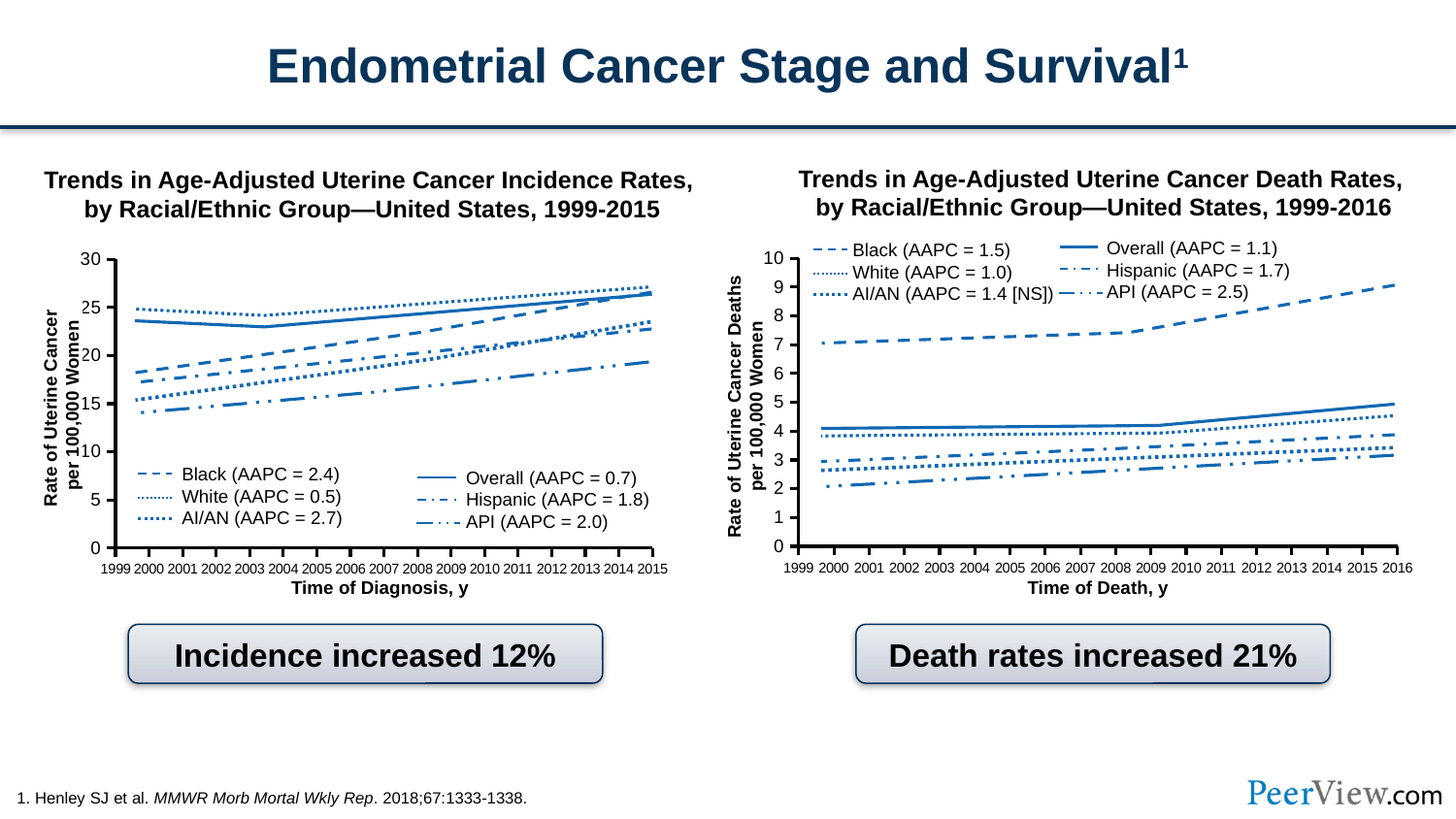
In the incidence rates chart (left), is the value for White in 1999 greater or less than 20? greater In the death rates chart (right), what AAPC value is listed for API in the legend? 2.5 In the death rates chart (right), how many series does the legend list? 6 What type of chart is the left chart showing uterine cancer incidence rates? Line chart In the incidence rates chart (left), how many series does the legend list? 6 In the death rates chart (right), is the value for API in 1999 greater or less than 3? less In the death rates chart (right), does the Black death rate rise or fall from 1999 to 2016? Rise In the incidence rates chart (left), what AAPC value is listed for Black in the legend? 2.4 In the death rates chart (right), is the value for Black in 2016 greater or less than 8? greater In the incidence rates chart (left), which group has the lowest incidence rate in 1999? API In the death rates chart (right), which group has the lowest death rate in 1999? API In the death rates chart (right), which racial/ethnic group has the highest death rate across the whole period? Black